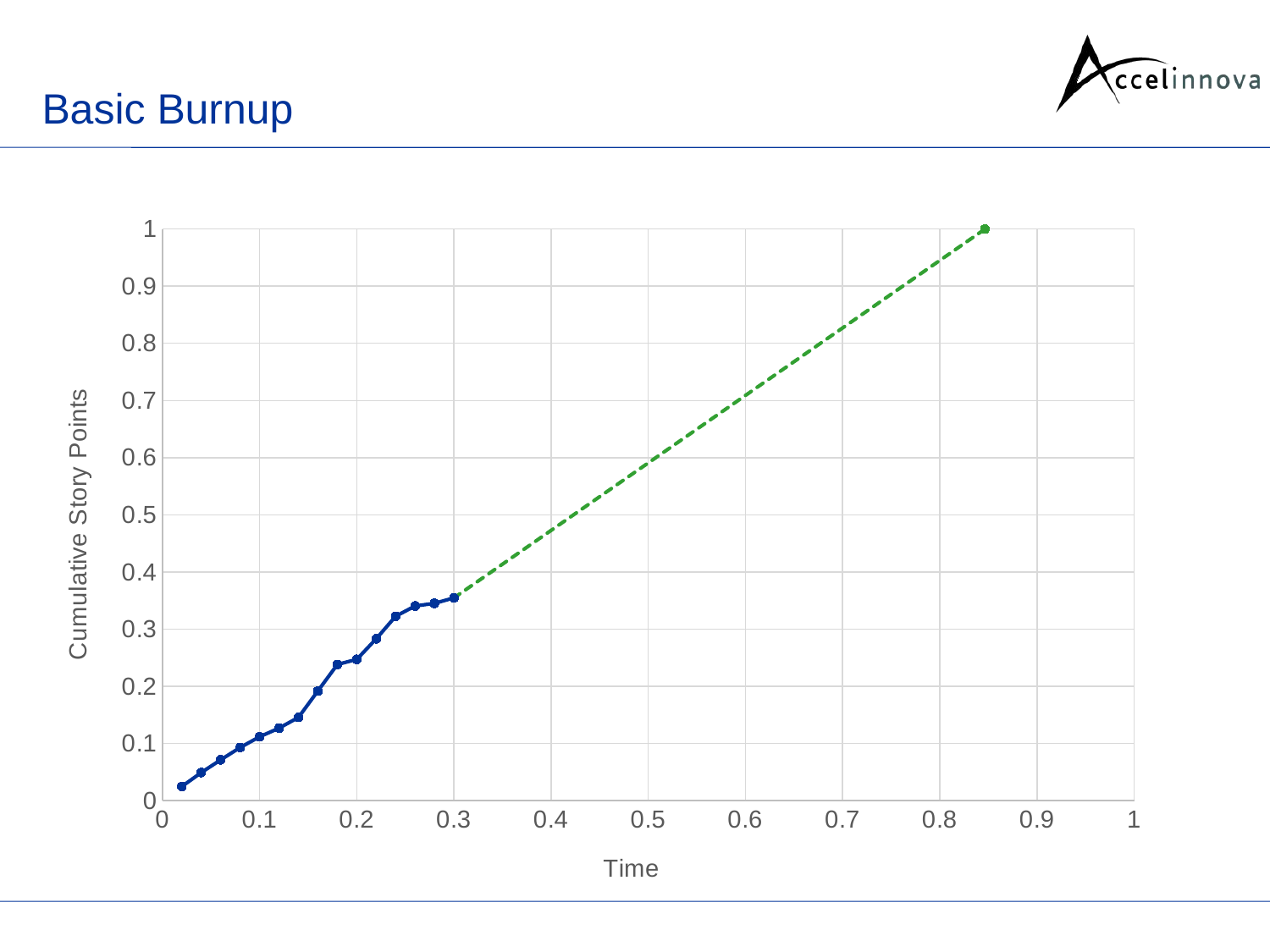
What Cumulative Story Points value does the green dashed line reach at its end point? 1 Is the value of the blue line at Time 0.2 greater or less than 0.3? less Is the value of the blue line at Time 0.3 greater or less than 0.4? less Is the value of the green dashed line at Time 0.6 greater or less than 0.6? greater What is the label of the vertical axis? Cumulative Story Points What is the title of the chart on the slide? Basic Burnup Do the values of the blue line rise or fall as Time increases? rise At which Time value does the blue line reach its highest point? 0.3 What kind of chart is shown on the slide? line chart Which is larger: the value of the blue line at Time 0.2 or at Time 0.1? Time 0.2